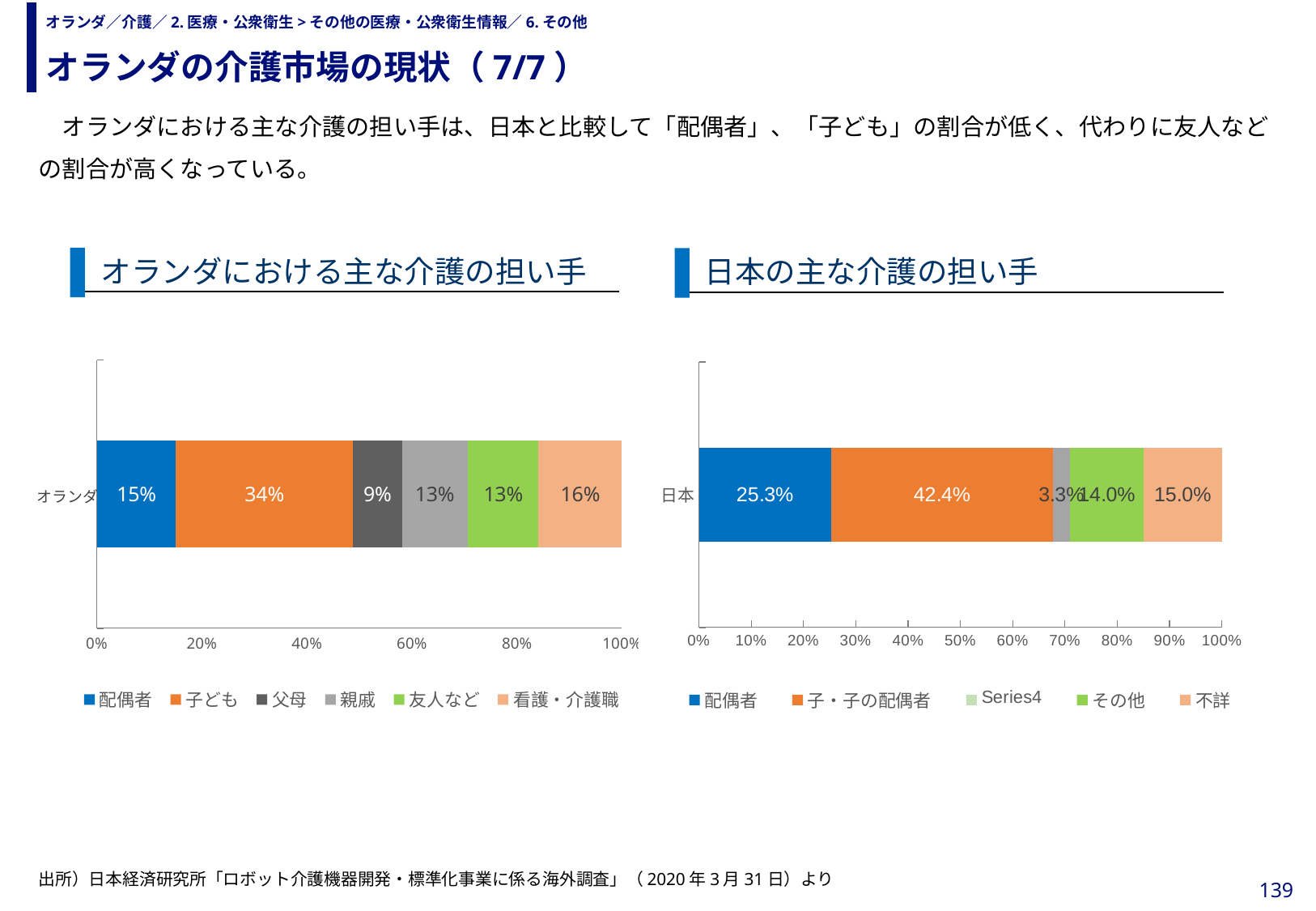
What kind of chart is the chart titled 日本の主な介護の担い手? Stacked bar chart In the chart titled オランダにおける主な介護の担い手, what is the value for 子ども? 34% In the chart titled オランダにおける主な介護の担い手, which series has the smallest value? 父母 In the chart titled 日本の主な介護の担い手, which series has the largest value? 子・子の配偶者 In the chart titled 日本の主な介護の担い手, what is the value for 子・子の配偶者? 42.4% How many series does the legend of the chart titled オランダにおける主な介護の担い手 list? 6 In the chart titled 日本の主な介護の担い手, which is larger, the value for 配偶者 or the value for 不詳? 配偶者 In the chart titled オランダにおける主な介護の担い手, what is the difference between the values for 子ども and 配偶者? 19% In the chart titled 日本の主な介護の担い手, what is the difference between the values for 不詳 and その他? 1.0% In the chart titled 日本の主な介護の担い手, what is the value for 配偶者? 25.3% In the chart titled オランダにおける主な介護の担い手, what is the value for 看護・介護職? 16% In the chart titled オランダにおける主な介護の担い手, which series has the largest value? 子ども